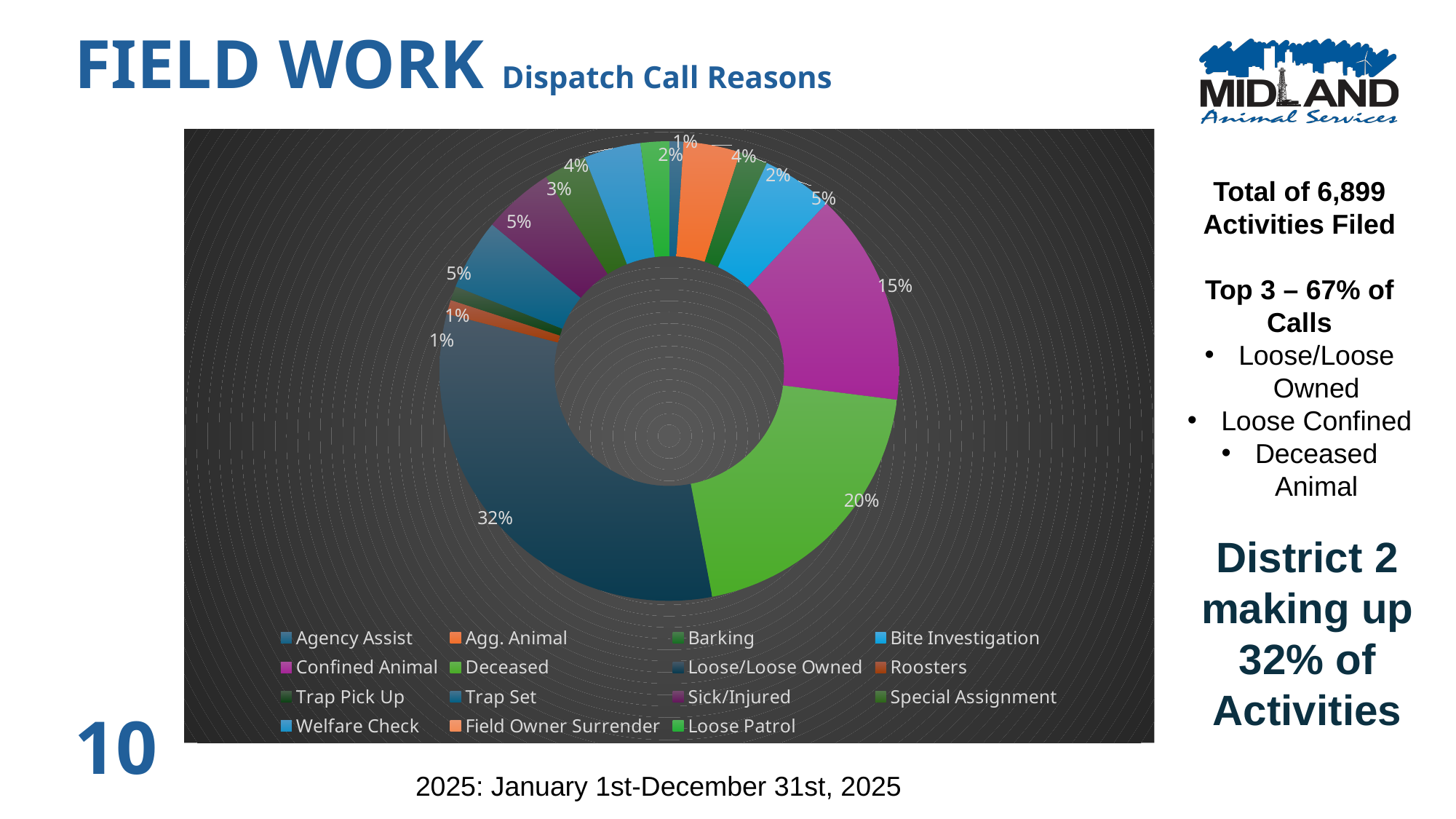
What percentage of dispatch calls is Deceased? 20% What share of dispatch calls is Loose/Loose Owned? 32% Which has a larger share, Deceased or Confined Animal? Deceased What percentage of dispatch calls is Confined Animal? 15% What percentage of dispatch calls is Sick/Injured? 5% Which dispatch call reason has the largest share of the chart? Loose/Loose Owned What kind of chart is shown on the slide? Doughnut (pie) chart What is the subtitle of the chart on the slide? Dispatch Call Reasons What is the combined share of the three largest slices (Loose/Loose Owned, Deceased, Confined Animal)? 67% How many dispatch call reasons are listed in the chart legend? 15 What percentage of dispatch calls is Agg. Animal? 4% What is the difference in percentage points between Loose/Loose Owned and Deceased? 12